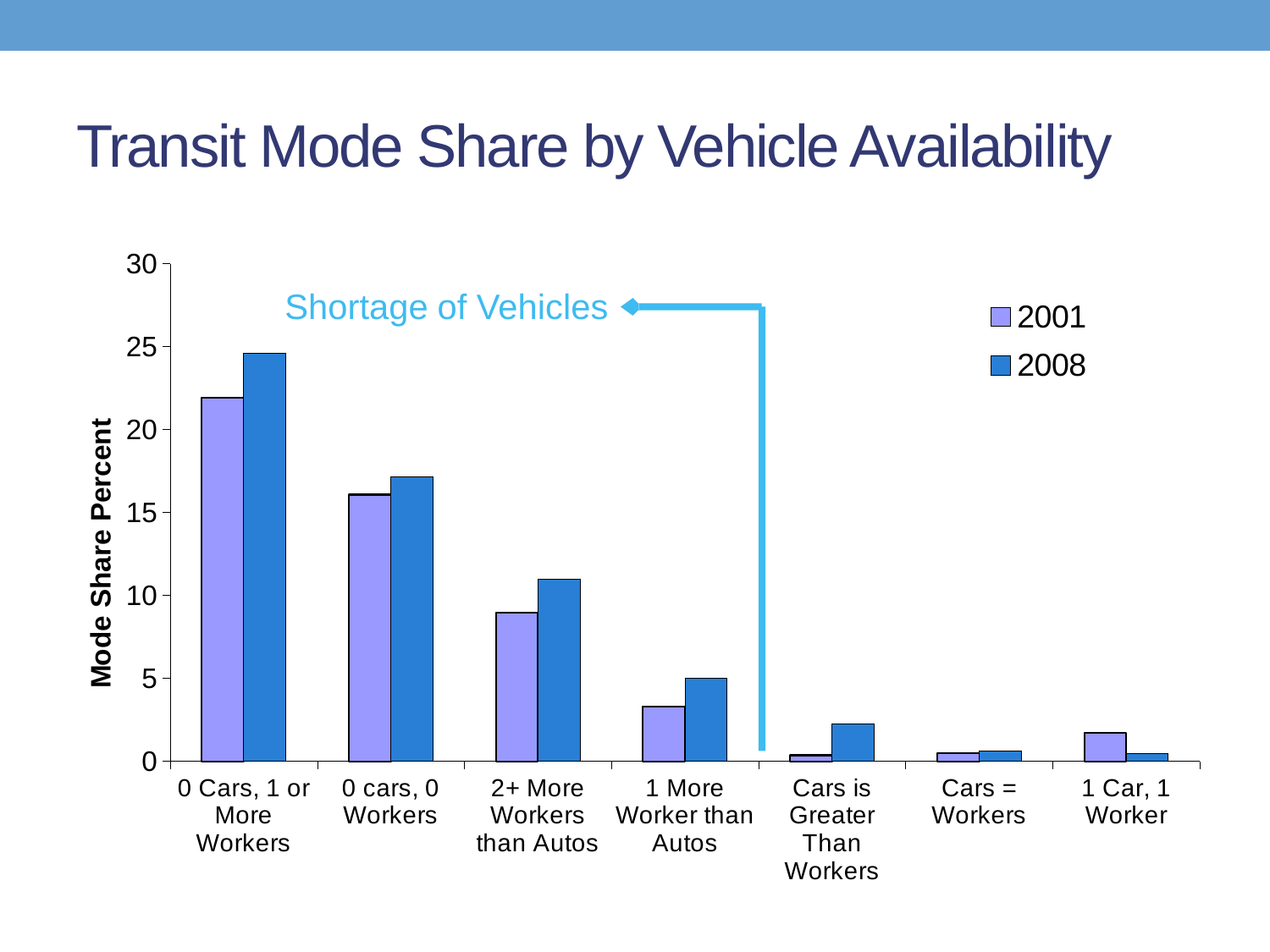
Is the 2001 value for '0 cars, 0 Workers' greater or less than 20? less Which category has the highest 2008 mode share? 0 Cars, 1 or More Workers For '1 Car, 1 Worker', which year has the larger mode share, 2001 or 2008? 2001 What is the title of the y axis? Mode Share Percent Is the 2001 value for '1 More Worker than Autos' greater or less than 5? less Do the 2008 values rise or fall moving from left to right across the categories? fall Which category has the highest 2001 mode share? 0 Cars, 1 or More Workers Is the 2008 value for '0 Cars, 1 or More Workers' greater or less than 20? greater What kind of chart is shown on the slide? Bar chart How many series does the legend list? 2 How many vehicle-availability categories are shown on the x axis? 7 For 'Cars is Greater Than Workers', which year has the larger mode share, 2001 or 2008? 2008